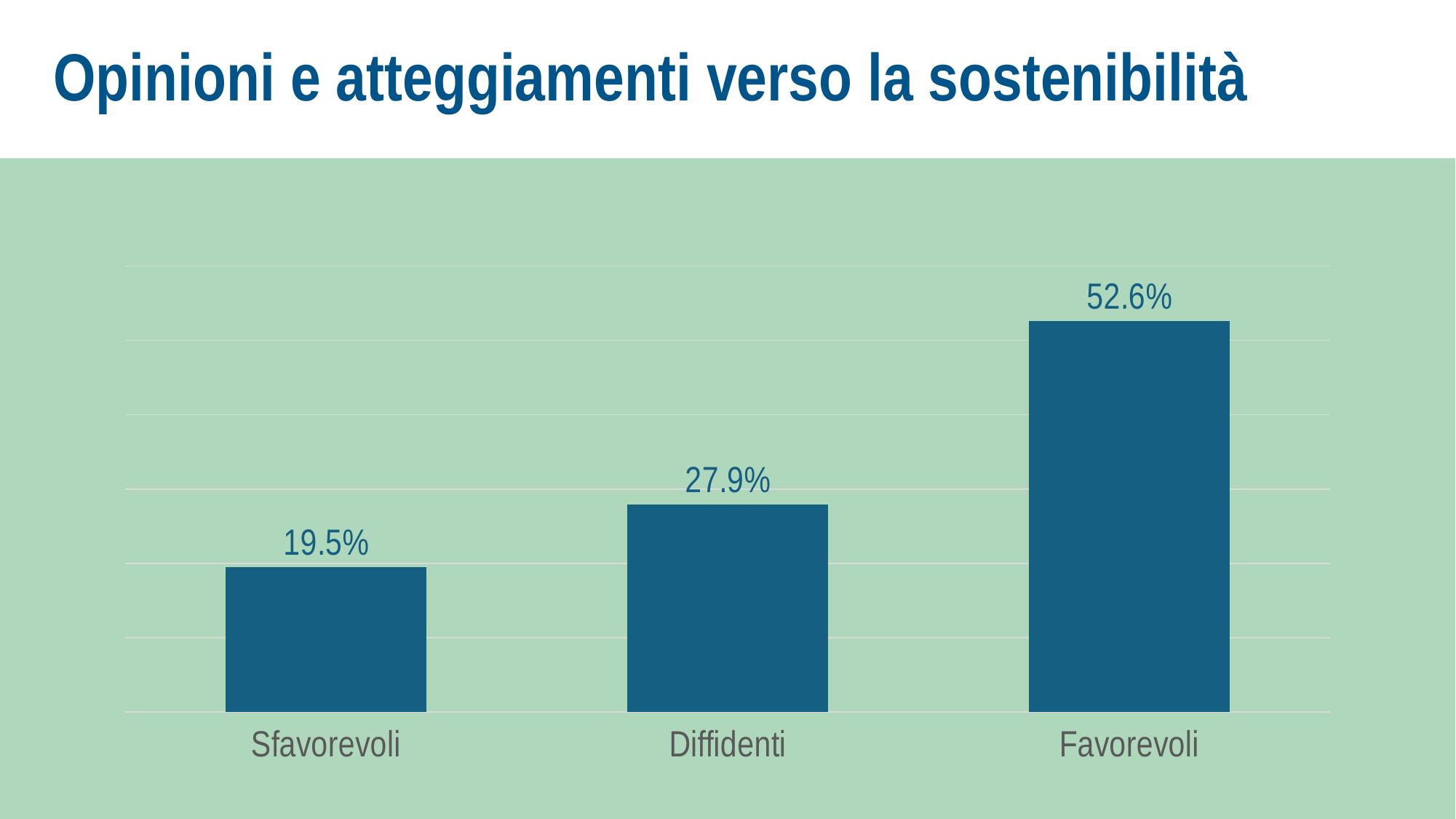
Which category has the lowest value? Sfavorevoli Which is larger, the value for Diffidenti or the value for Sfavorevoli? Diffidenti What is the title of the slide? Opinioni e atteggiamenti verso la sostenibilità What is the value for Diffidenti? 27.9% What kind of chart is shown on the slide? Bar chart What is the difference between the values for Diffidenti and Sfavorevoli? 8.4% What is the difference between the values for Favorevoli and Diffidenti? 24.7% Do the values rise or fall from left to right along the x axis? Rise How many categories are shown in the chart? 3 What is the value for Favorevoli? 52.6% What is the value for Sfavorevoli? 19.5% Which category has the highest value? Favorevoli